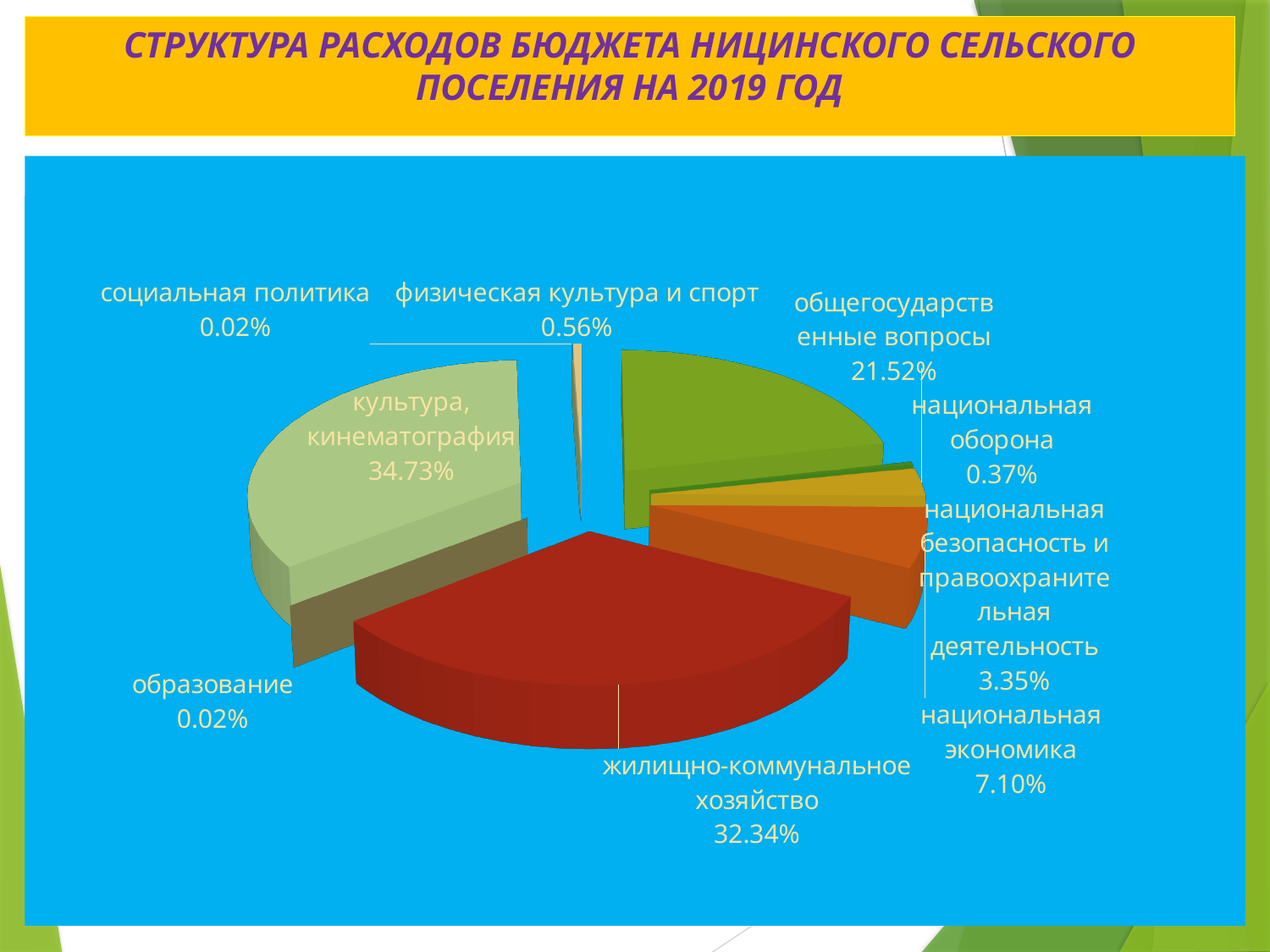
Which is larger: общегосударственные вопросы or национальная экономика? общегосударственные вопросы What percentage is shown for национальная оборона? 0.37% By how many percentage points does культура, кинематография exceed жилищно-коммунальное хозяйство? 2.39 What type of chart is shown on the slide? pie chart What share of the budget expenditure goes to культура, кинематография? 34.73% What share is labelled for национальная экономика? 7.10% What is the value for общегосударственные вопросы? 21.52% What percentage is shown for жилищно-коммунальное хозяйство? 32.34% What is the title of the slide? СТРУКТУРА РАСХОДОВ БЮДЖЕТА НИЦИНСКОГО СЕЛЬСКОГО ПОСЕЛЕНИЯ НА 2019 ГОД How many categories are shown in the pie chart? 9 Which category has the largest share of the pie? культура, кинематография What is the difference between общегосударственные вопросы and национальная экономика in percentage points? 14.42